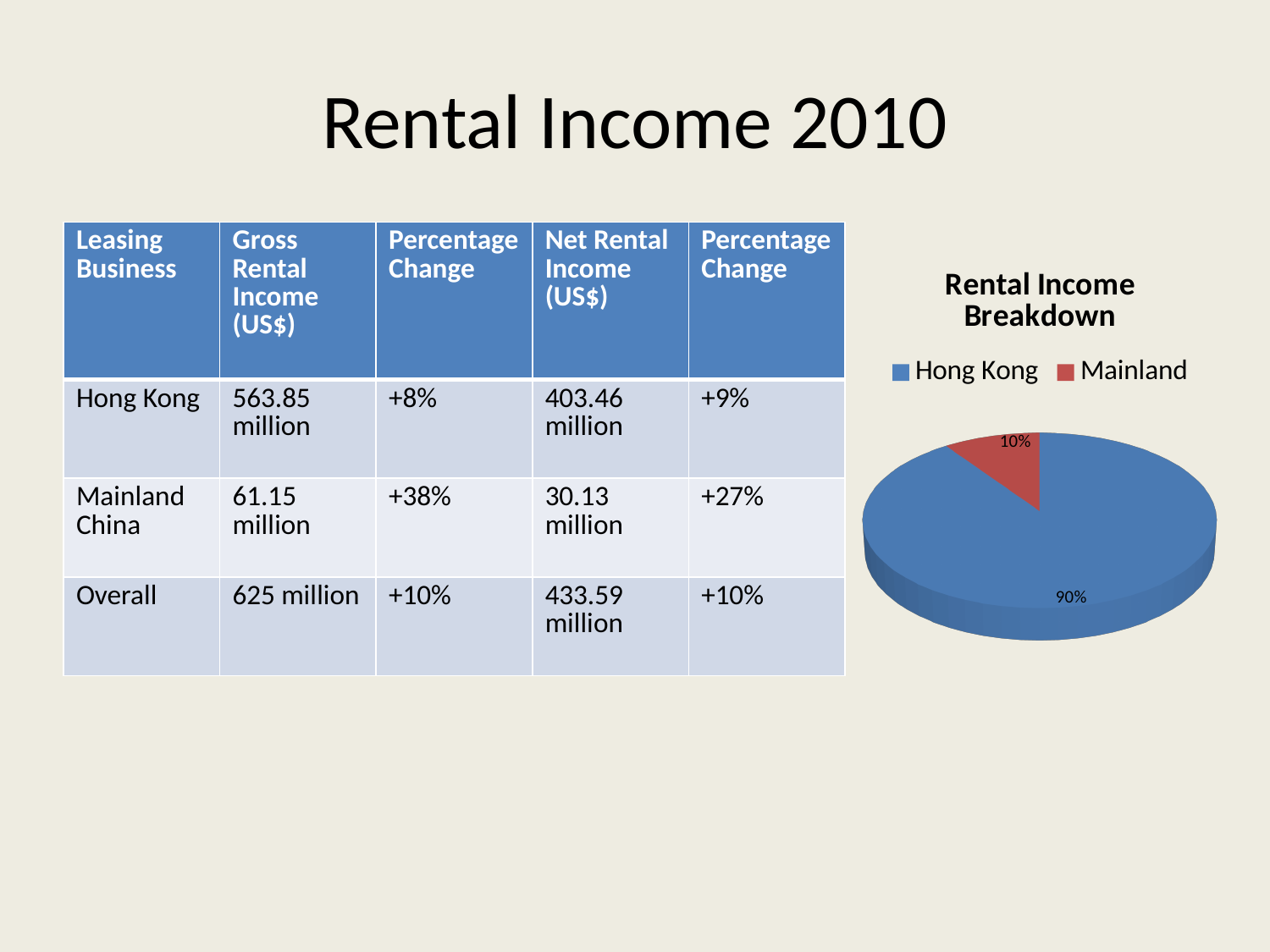
How many entries does the legend of the Rental Income Breakdown chart list? 2 What share of the Rental Income Breakdown pie does Mainland account for? 10% What kind of chart is the Rental Income Breakdown chart? pie chart What share of the Rental Income Breakdown pie does Hong Kong account for? 90% What colour is the Mainland slice in the Rental Income Breakdown chart? red Which slice of the Rental Income Breakdown pie is the smallest? Mainland What is the difference in percentage points between the Hong Kong and Mainland slices in the Rental Income Breakdown chart? 80 How many slices does the Rental Income Breakdown pie chart have? 2 What is the title of the pie chart on the slide? Rental Income Breakdown In the Rental Income Breakdown chart, which is larger, the Hong Kong slice or the Mainland slice? Hong Kong Which slice of the Rental Income Breakdown pie is the largest? Hong Kong